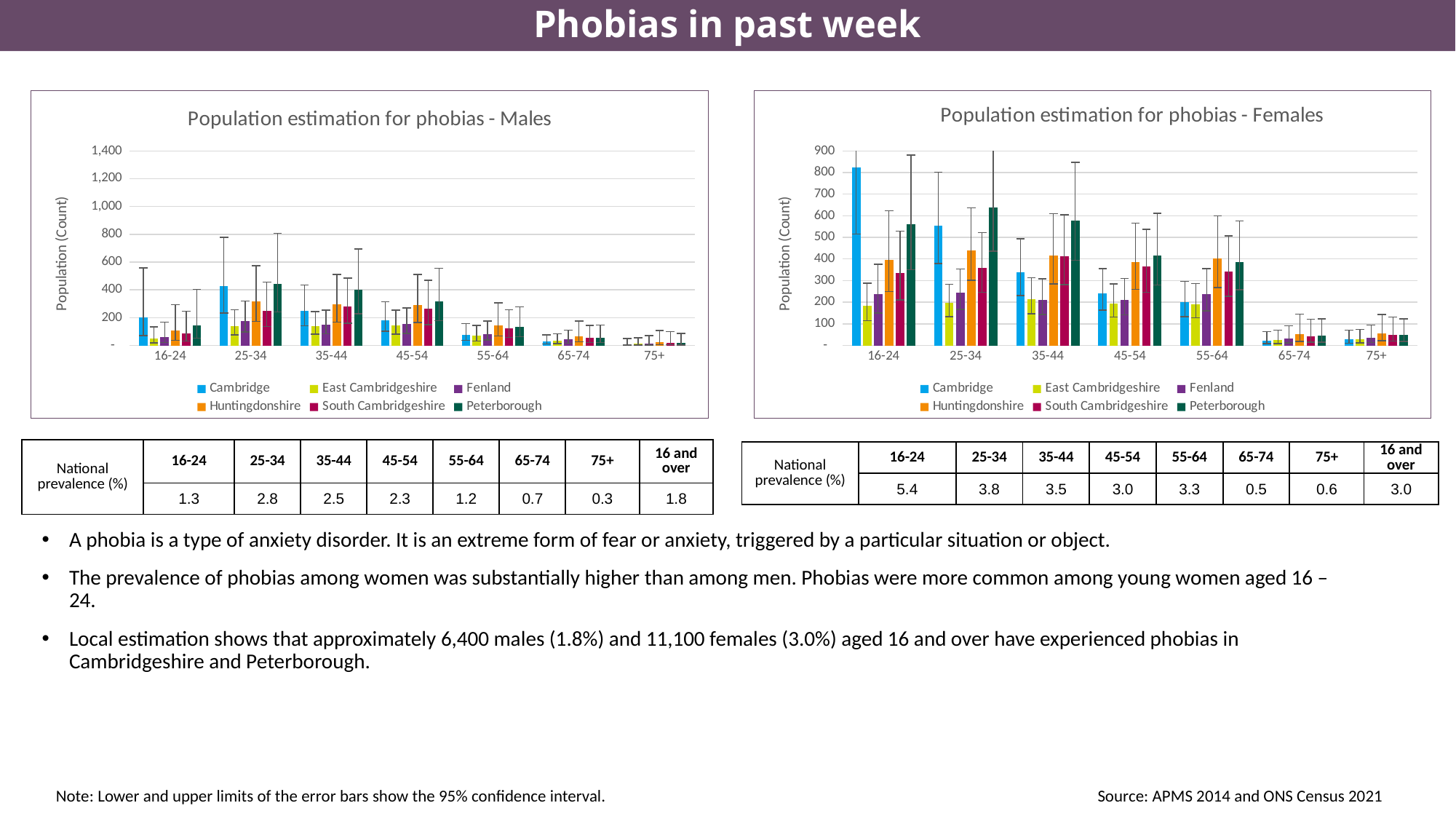
In the 'Population estimation for phobias - Females' chart, is the value for Cambridge in the 16-24 age group greater or less than 700? greater In the 'Population estimation for phobias - Females' chart, is the value for Peterborough in the 25-34 age group greater or less than 500? greater What kind of chart is 'Population estimation for phobias - Males'? bar chart How many age groups are shown on the x axis of the 'Population estimation for phobias - Females' chart? 7 In the 'Population estimation for phobias - Males' chart, which is larger for Cambridge: the 25-34 age group or the 65-74 age group? 25-34 In the 'Population estimation for phobias - Males' chart, is the value for Peterborough in the 75+ age group greater or less than 200? less In the 'Population estimation for phobias - Females' chart, which is larger for the 16-24 age group: Cambridge or East Cambridgeshire? Cambridge In the 'Population estimation for phobias - Males' chart, do the Cambridge values rise or fall from the 25-34 age group to the 75+ age group? fall In the 'Population estimation for phobias - Females' chart, which area and age group has the highest bar? Cambridge, 16-24 What is the y-axis label on the 'Population estimation for phobias - Females' chart? Population (Count) How many series does the legend of the 'Population estimation for phobias - Males' chart list? 6